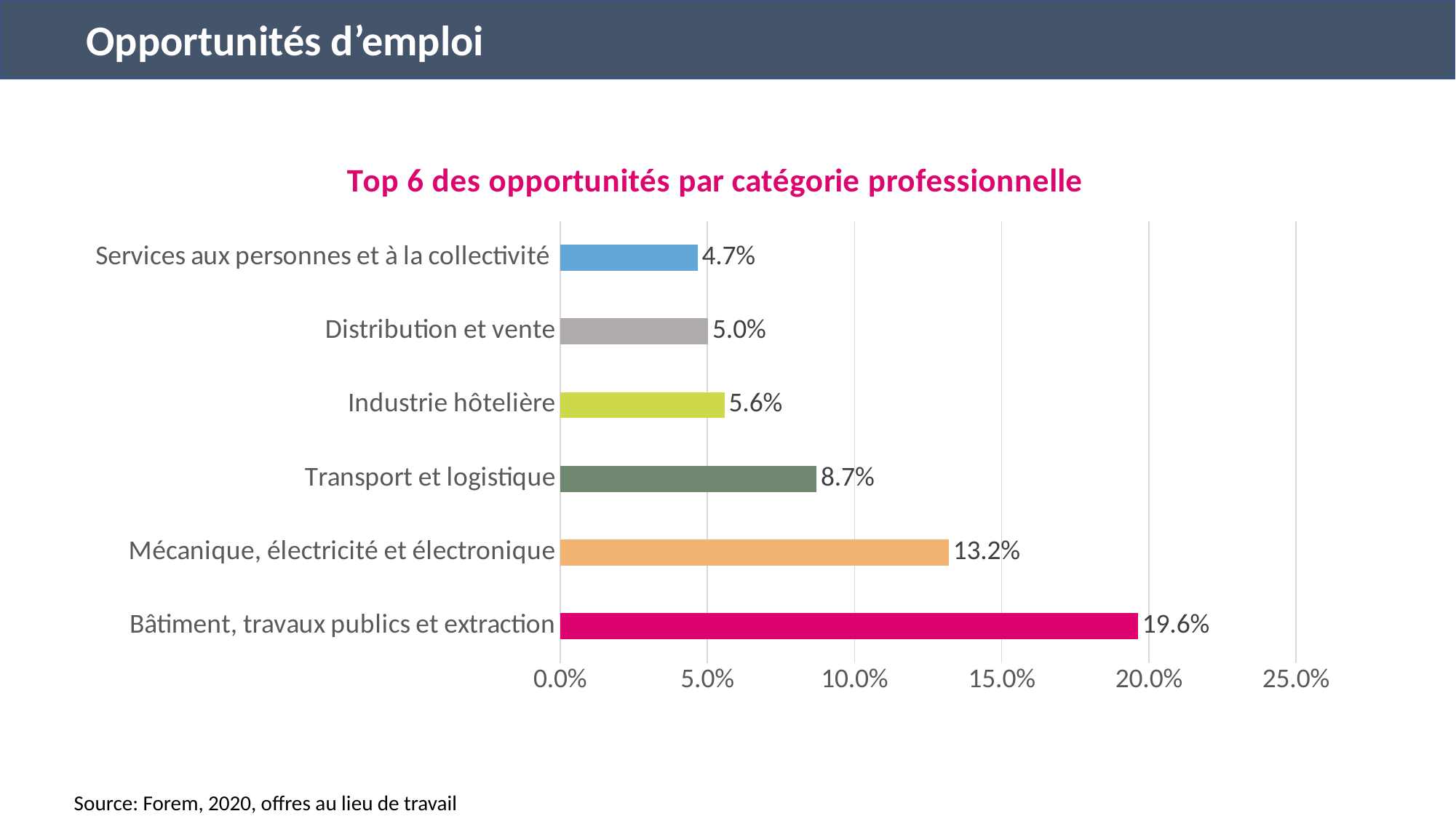
How many categories are shown in the chart? 6 Is the value for Mécanique, électricité et électronique greater or less than 10.0%? greater Which is larger, the value for Mécanique, électricité et électronique or the value for Transport et logistique? Mécanique, électricité et électronique What is the difference between the values for Transport et logistique and Distribution et vente? 3.7% What is the value for Industrie hôtelière? 5.6% Which category has the highest value? Bâtiment, travaux publics et extraction What is the difference between the values for Bâtiment, travaux publics et extraction and Mécanique, électricité et électronique? 6.4% What is the value for Bâtiment, travaux publics et extraction? 19.6% Which category has the lowest value? Services aux personnes et à la collectivité What is the title of the chart? Top 6 des opportunités par catégorie professionnelle What is the value for Transport et logistique? 8.7% What kind of chart is shown on the slide? Bar chart